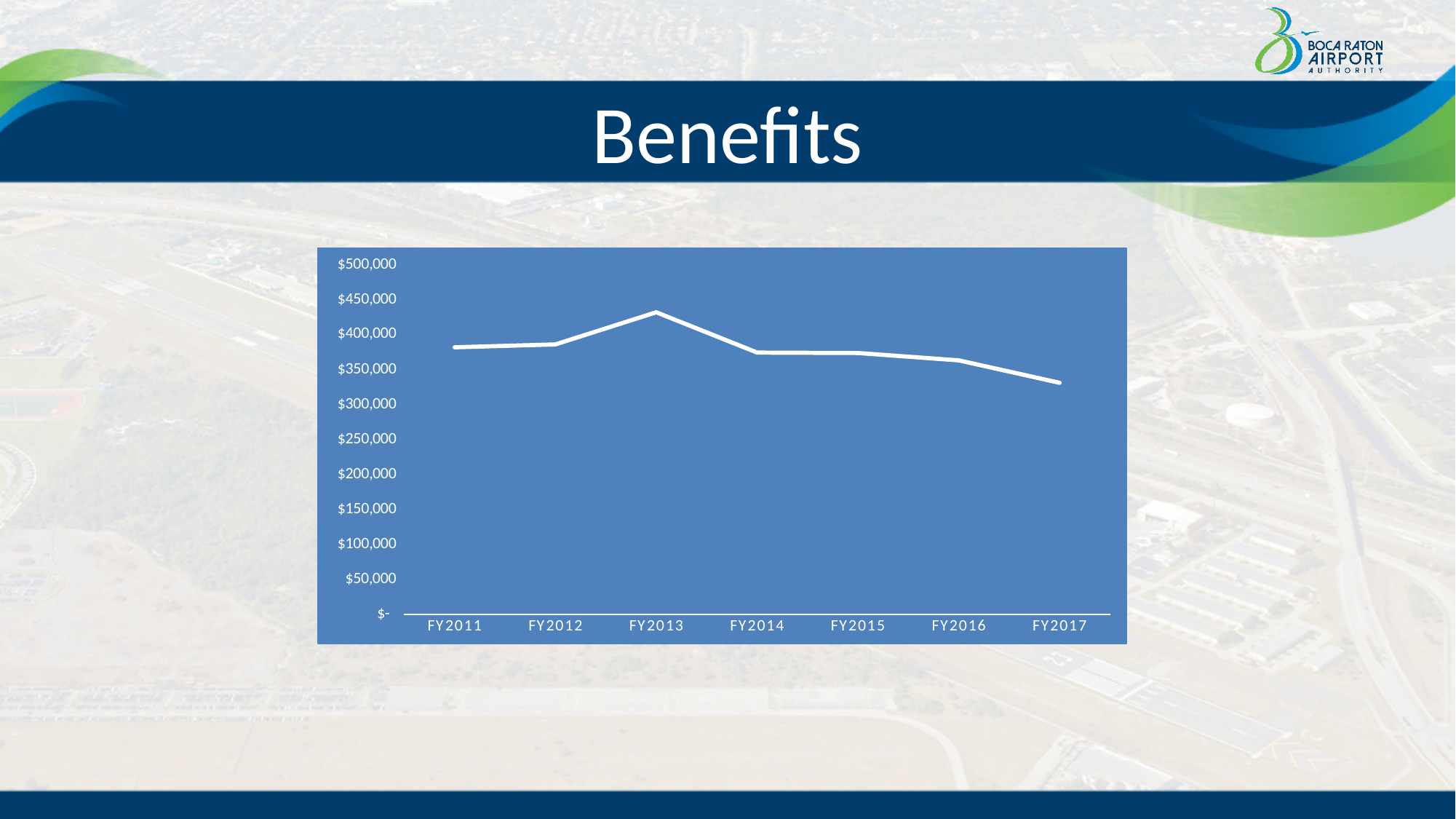
Is the value for FY2015 greater or less than $400,000? less How many fiscal years are plotted on the x axis? 7 Is the value for FY2011 greater or less than $350,000? greater Which is larger, the value for FY2011 or the value for FY2017? FY2011 Which fiscal year has the lowest benefits value? FY2017 What kind of chart is shown on the slide? line chart Is the value for FY2013 greater or less than $400,000? greater Which fiscal year has the highest benefits value? FY2013 Which is larger, the value for FY2013 or the value for FY2017? FY2013 What is the title of the slide containing the chart? Benefits Do the values rise or fall from FY2013 to FY2017? fall